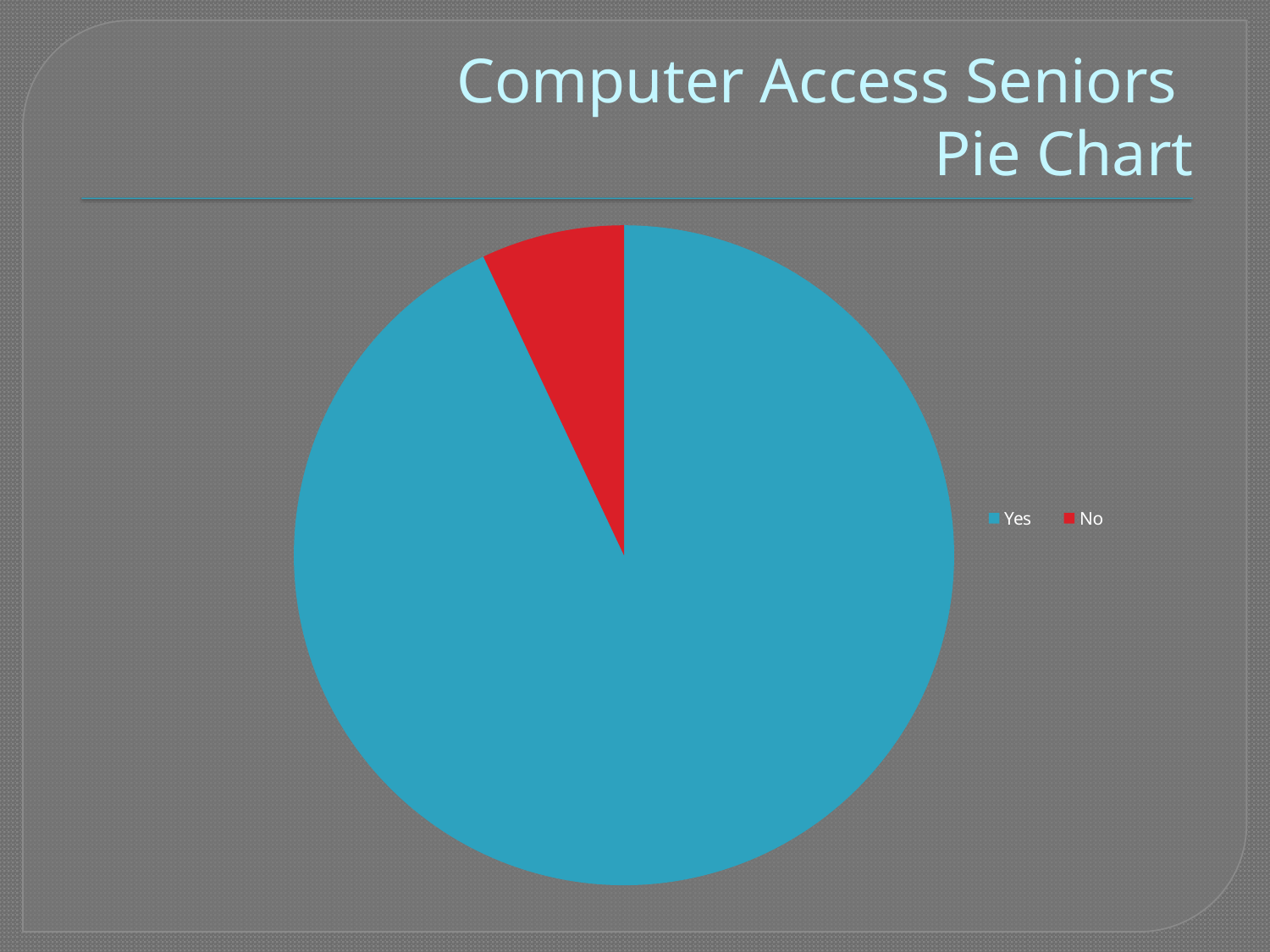
Which category has the smallest slice of the pie? No Which slice is larger, Yes or No? Yes Which category has the largest slice of the pie? Yes What colour is the No slice in the pie chart? Red What kind of chart is shown on the slide? Pie chart Is the Yes slice larger or smaller than the No slice? Larger What is the title of the slide containing the chart? Computer Access Seniors Pie Chart How many slices does the pie chart have? 2 How many entries does the legend list? 2